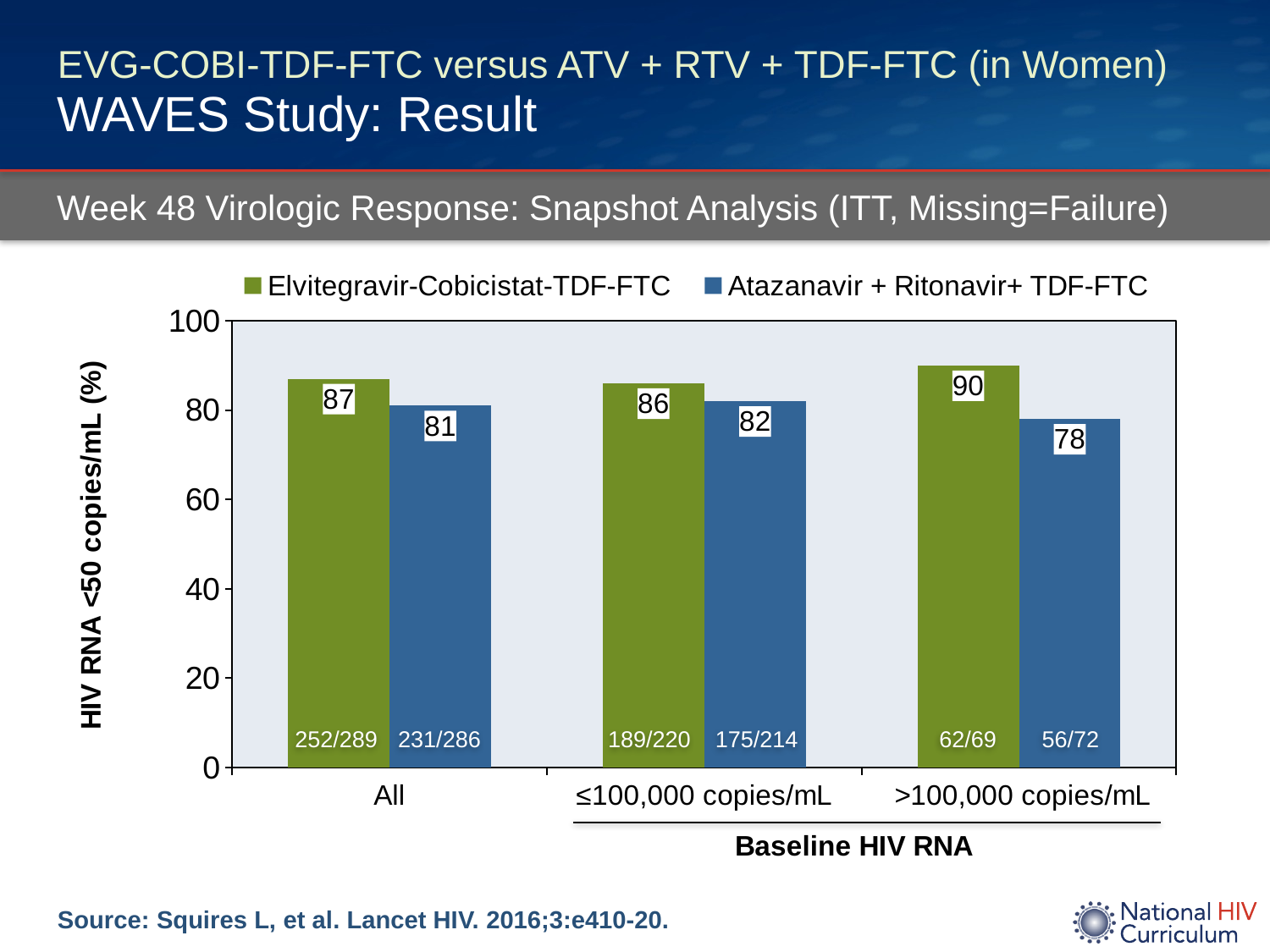
Which series has the larger value in the ≤100,000 copies/mL category? Elvitegravir-Cobicistat-TDF-FTC What is the value for Elvitegravir-Cobicistat-TDF-FTC in the All category? 87 What is the value for Atazanavir + Ritonavir+ TDF-FTC in the ≤100,000 copies/mL category? 82 In which category does Atazanavir + Ritonavir+ TDF-FTC have its lowest value? >100,000 copies/mL What is the difference between the two series in the >100,000 copies/mL category? 12 What kind of chart is shown on the slide? Bar chart What is the value for Atazanavir + Ritonavir+ TDF-FTC in the >100,000 copies/mL category? 78 What is the difference between the two series in the All category? 6 What fraction is printed at the base of the Atazanavir + Ritonavir+ TDF-FTC bar in the All category? 231/286 In which category does Elvitegravir-Cobicistat-TDF-FTC have its highest value? >100,000 copies/mL How many series does the legend list? 2 How many categories are shown on the x axis? 3